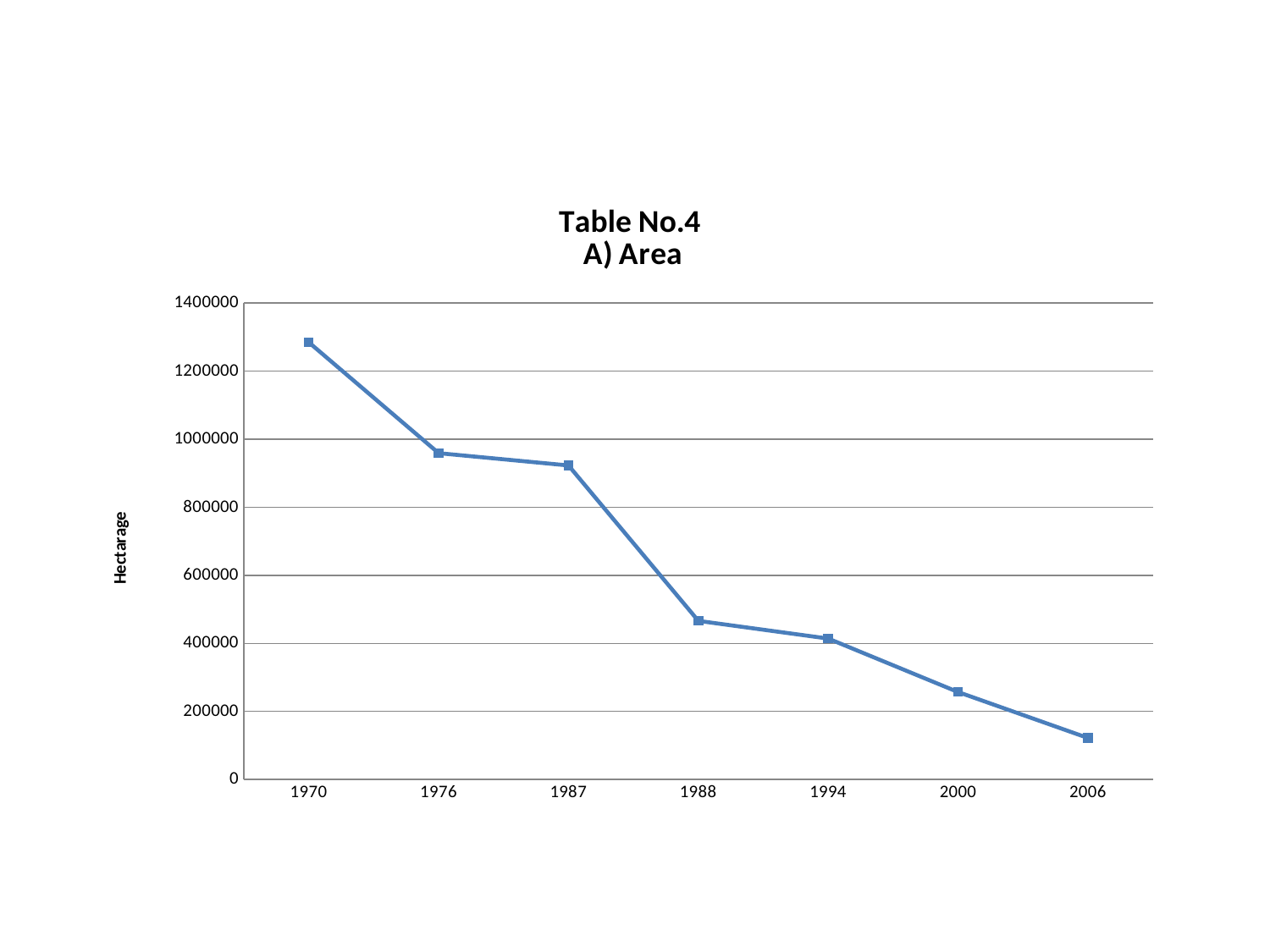
Is the value for 1988 greater or less than 600000? less What kind of chart is shown on the slide? line chart Which is larger, the value for 1987 or the value for 1994? 1987 Which year has the lowest hectarage value? 2006 What is the title of the chart? Table No.4 A) Area Do the values rise or fall from 1970 to 2006? fall How many data points are plotted on the chart? 7 Is the value for 1976 greater or less than 1000000? less Is the value for 2000 greater or less than 200000? greater What is the label on the vertical axis? Hectarage Which year has the highest hectarage value? 1970